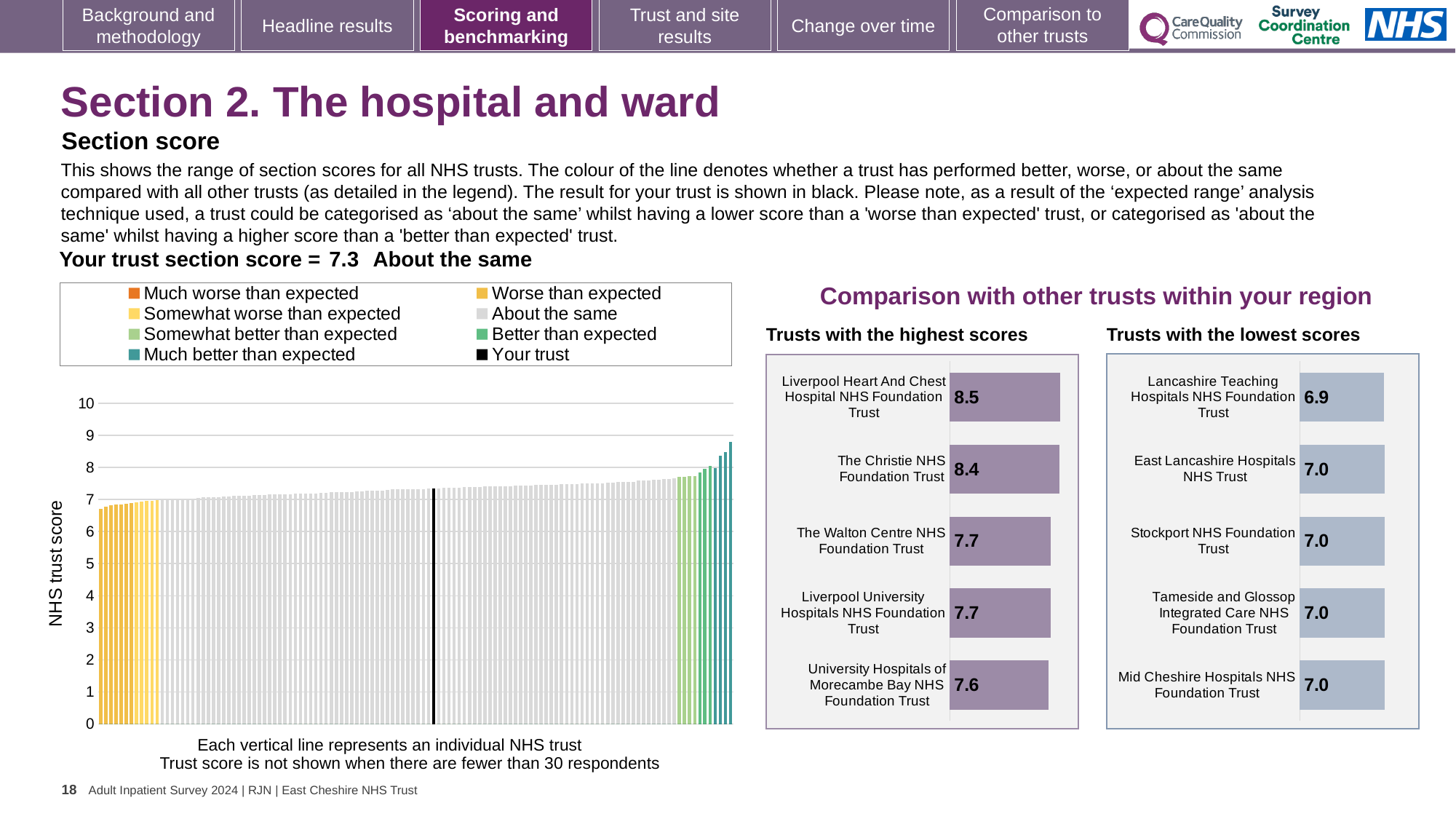
What is the y-axis label of the large chart on the left? NHS trust score What kind of chart is the large chart on the left showing all NHS trust scores? Bar chart In the 'Trusts with the highest scores' chart, what is the score for Liverpool Heart And Chest Hospital NHS Foundation Trust? 8.5 In the 'Trusts with the lowest scores' chart, what is the score for Lancashire Teaching Hospitals NHS Foundation Trust? 6.9 In the 'Trusts with the highest scores' chart, which has the higher score: The Walton Centre NHS Foundation Trust or University Hospitals of Morecambe Bay NHS Foundation Trust? The Walton Centre NHS Foundation Trust In the 'Trusts with the highest scores' chart, what is the score for The Christie NHS Foundation Trust? 8.4 In the 'Trusts with the highest scores' chart, which trust has the highest score? Liverpool Heart And Chest Hospital NHS Foundation Trust How many trusts are shown in the 'Trusts with the lowest scores' chart? 5 In the 'Trusts with the highest scores' chart, what is the difference between the scores of Liverpool Heart And Chest Hospital NHS Foundation Trust and The Christie NHS Foundation Trust? 0.1 In the 'Trusts with the lowest scores' chart, which trust has the lowest score? Lancashire Teaching Hospitals NHS Foundation Trust How many entries does the legend of the large chart on the left list? 8 In the large chart on the left, what is the section score for your trust (the black bar)? 7.3